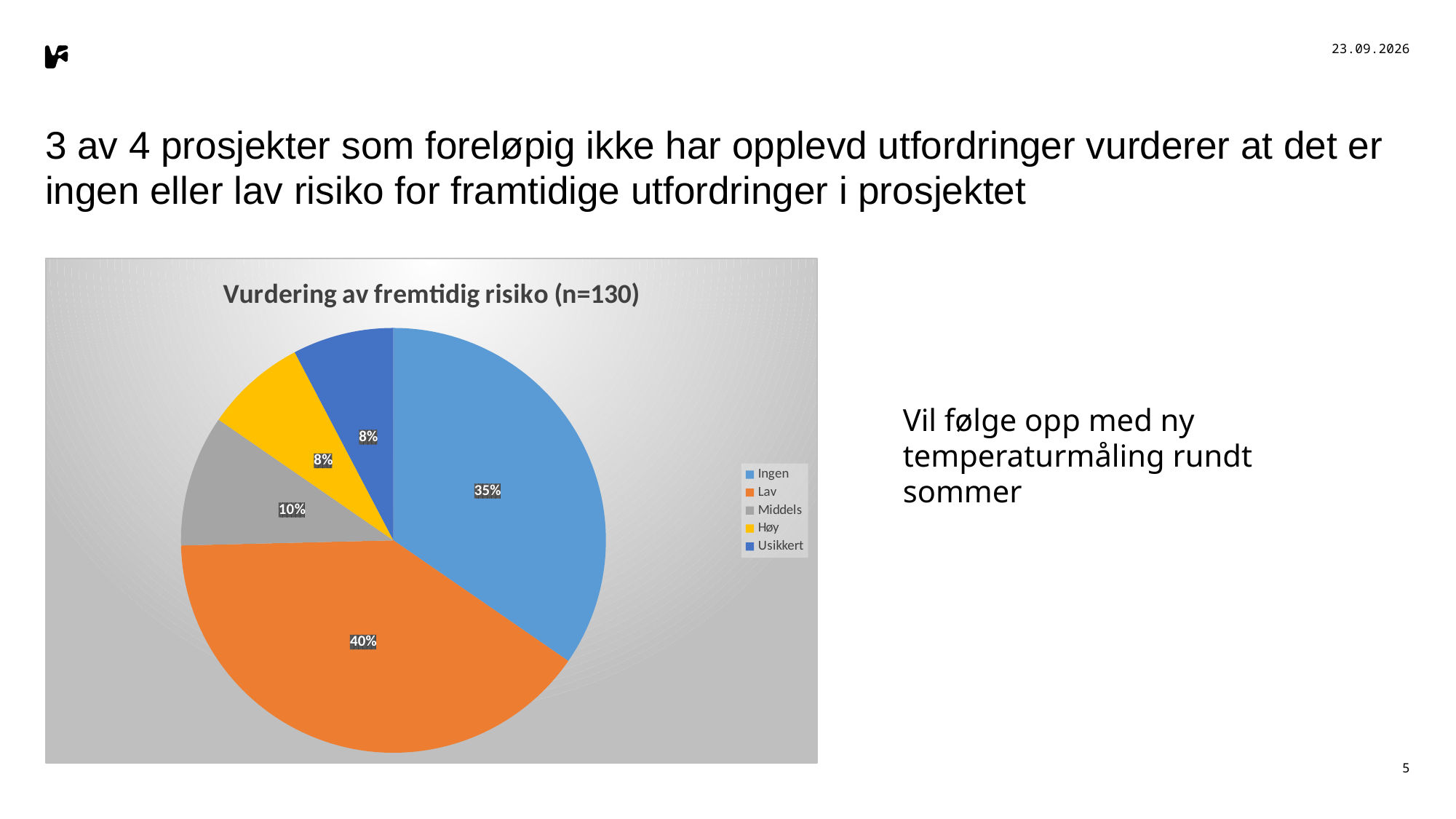
What is the value shown for 'Høy'? 8% Which category has the largest slice of the pie? Lav What share of the pie does the 'Lav' slice represent? 40% What share of the pie does the 'Ingen' slice represent? 35% What is the value shown for 'Usikkert'? 8% What is the title of the chart? Vurdering av fremtidig risiko (n=130) What is the value shown for 'Middels'? 10% What colour is the 'Høy' slice in the pie chart? yellow What type of chart is shown on the slide? pie chart What is the difference in percentage points between 'Lav' and 'Ingen'? 5 percentage points How many categories does the pie chart have? 5 Which is larger, the slice for 'Ingen' or the slice for 'Middels'? Ingen